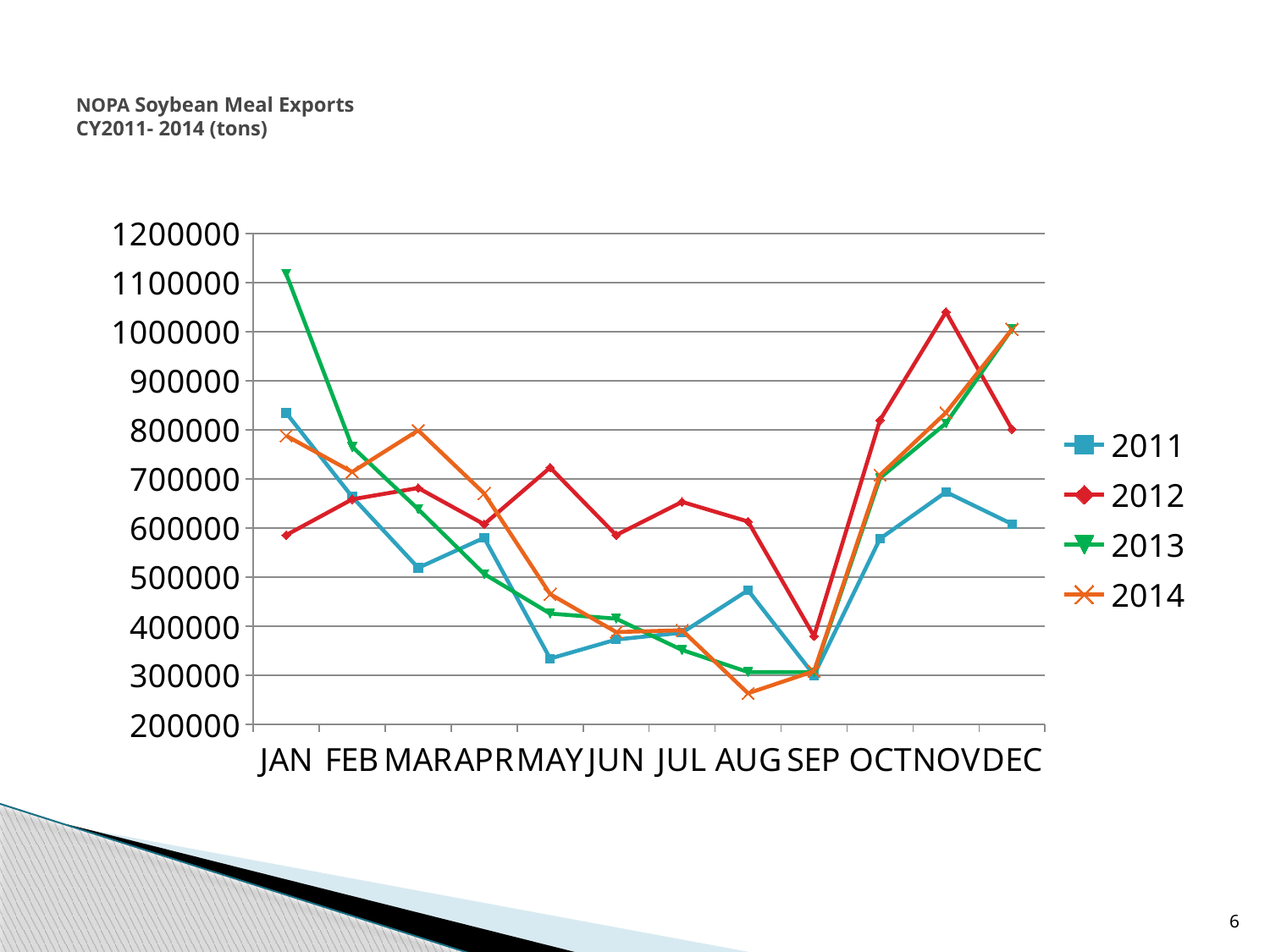
In which month does the 2014 series reach its lowest value? AUG In which month does the 2011 series reach its lowest value? SEP In JAN, which series has the larger value, 2011 or 2012? 2011 Does the 2012 series rise or fall from SEP to NOV? rise What kind of chart is shown on the slide? line chart How many series does the legend list? 4 Is the 2013 value for JAN greater or less than 1000000? greater In which month does the 2013 series reach its highest value? JAN Is the 2014 value for AUG greater or less than 300000? less Is the 2012 value for NOV greater or less than 1000000? greater How many months are plotted along the x axis? 12 Which series has the highest value in NOV? 2012